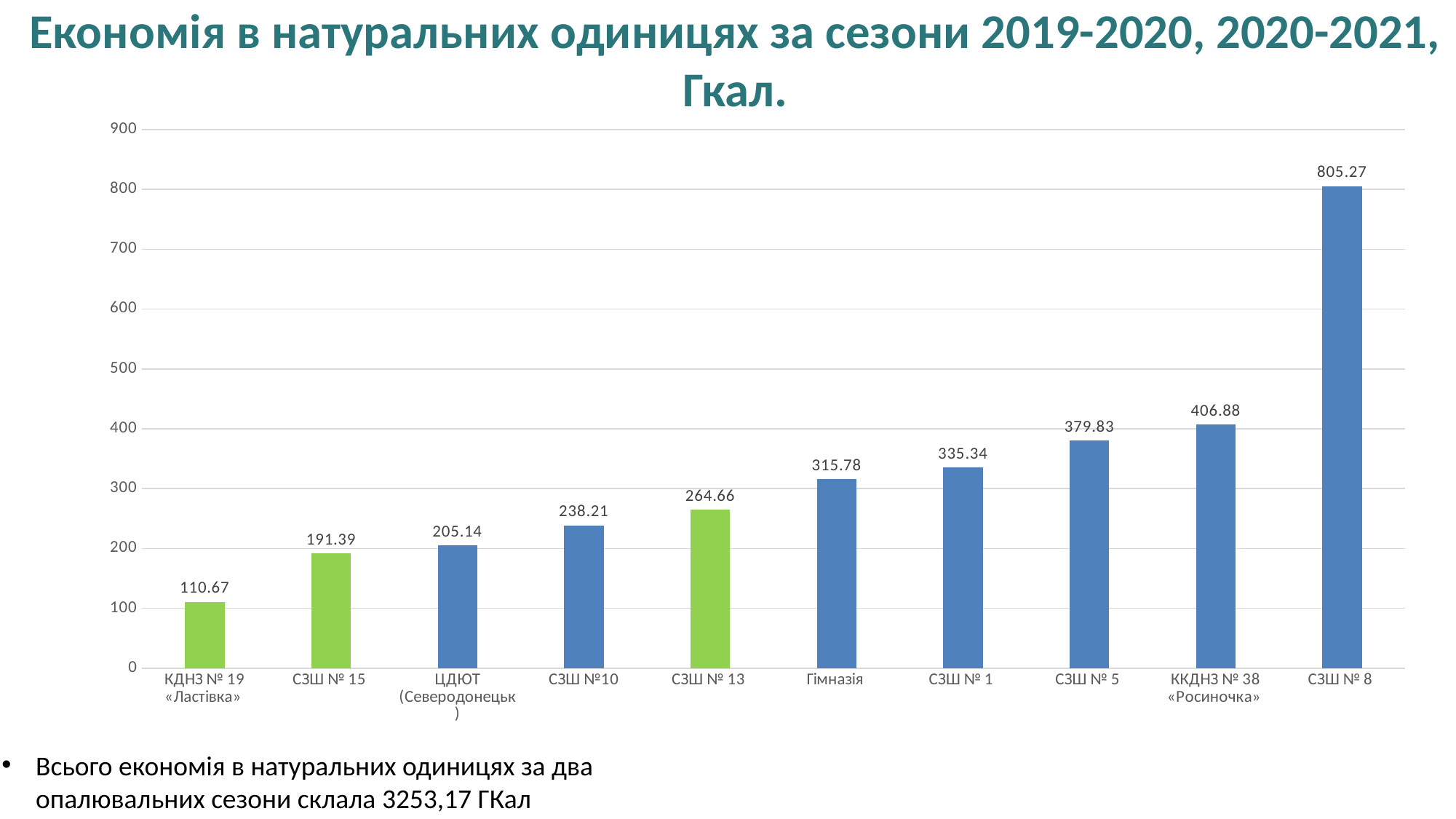
Which category has the highest value? СЗШ № 8 What is the difference between the values for СЗШ № 8 and ККДНЗ № 38 «Росиночка»? 398.39 Which is larger, the value for СЗШ № 5 or the value for СЗШ № 1? СЗШ № 5 What kind of chart is shown on the slide? bar chart Is the value for ЦДЮТ (Северодонецьк) greater or less than 300? less What is the difference between the values for СЗШ № 13 and СЗШ №10? 26.45 What is the value for СЗШ № 8? 805.27 What is the value for КДНЗ № 19 «Ластівка»? 110.67 Do the values rise or fall from left to right along the x axis? rise What is the value for Гімназія? 315.78 How many categories are shown on the x axis? 10 Which category has the lowest value? КДНЗ № 19 «Ластівка»